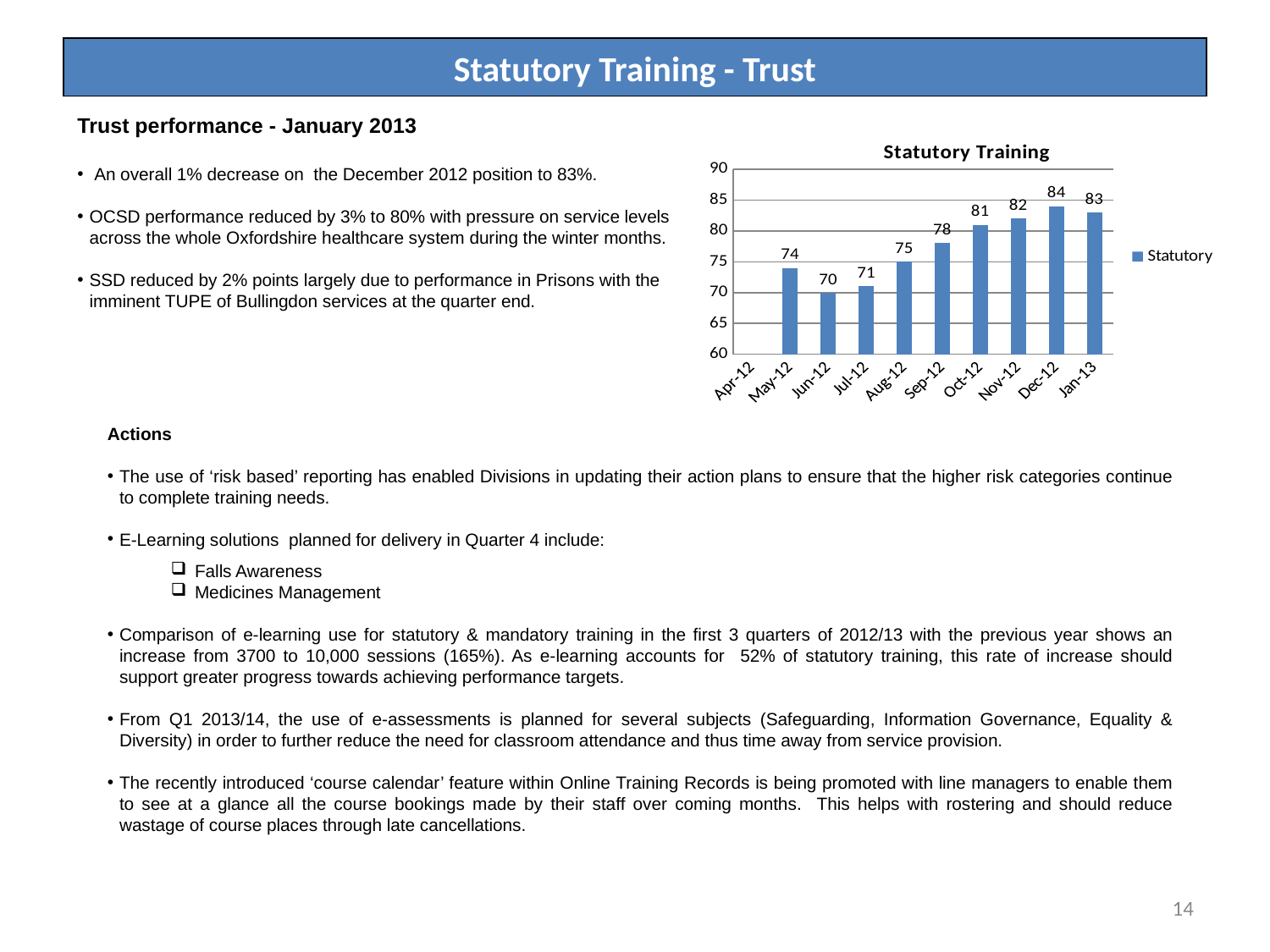
What is the difference between the May-12 and Oct-12 values in the Statutory Training chart? 7 Which month has the highest value in the Statutory Training chart? Dec-12 Which is larger in the Statutory Training chart, the value for Aug-12 or the value for Nov-12? Nov-12 What is the difference between the Dec-12 and Jan-13 values in the Statutory Training chart? 1 What is the value for Sep-12 in the Statutory Training chart? 78 How many bars are plotted in the Statutory Training chart? 9 What is the value for Jun-12 in the Statutory Training chart? 70 What type of chart is the Statutory Training chart? Bar chart What is the value for Dec-12 in the Statutory Training chart? 84 Which month has the lowest value in the Statutory Training chart? Jun-12 How many series does the legend of the Statutory Training chart list? 1 What is the value for Jan-13 in the Statutory Training chart? 83